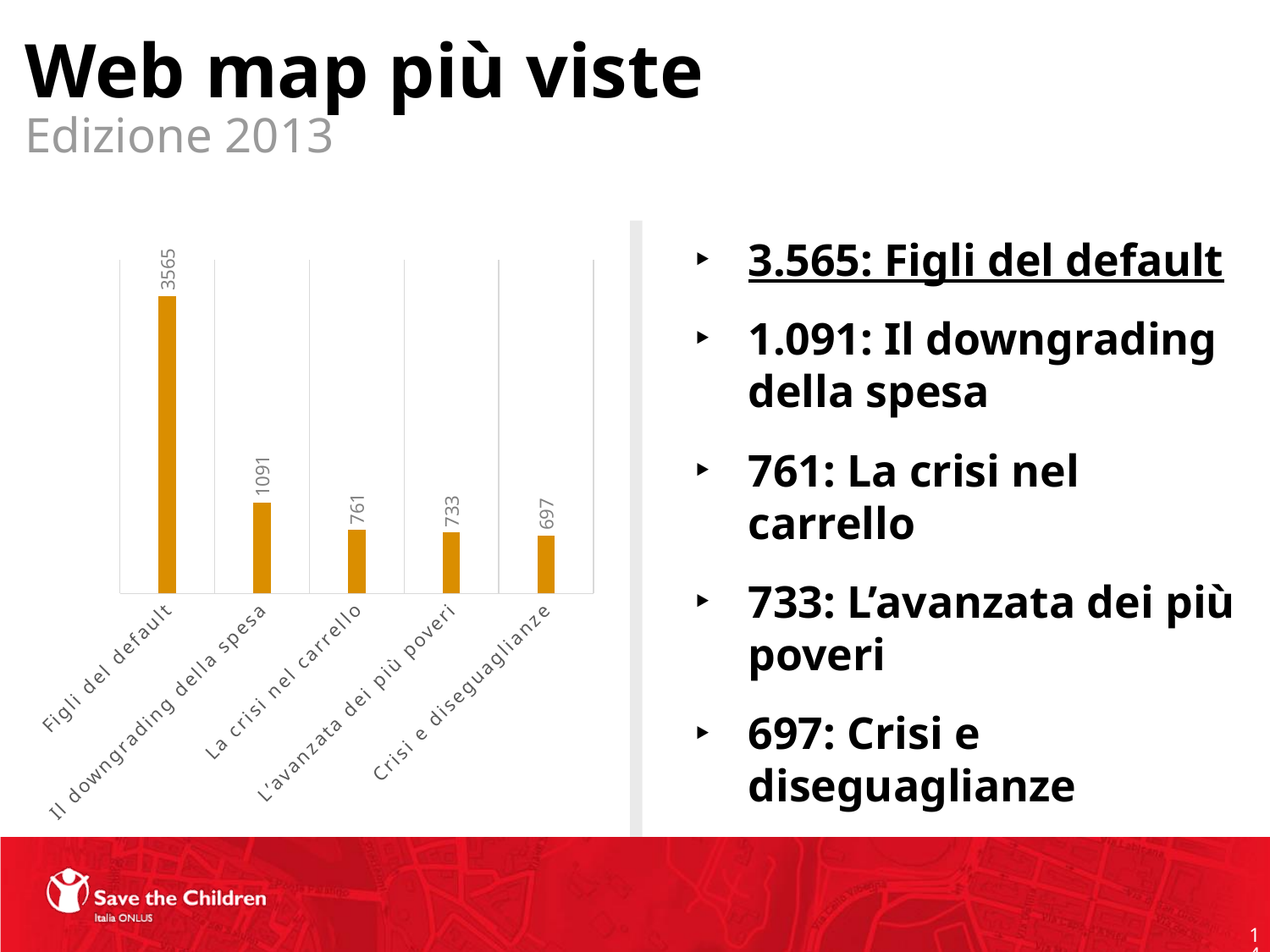
Which category has the highest value? Figli del default What is the value for Il downgrading della spesa? 1091 What is the value for Figli del default? 3565 What is the value for Crisi e diseguaglianze? 697 Which category has the lowest value? Crisi e diseguaglianze How many categories are shown in the chart? 5 Which is larger, the value for Il downgrading della spesa or the value for La crisi nel carrello? Il downgrading della spesa What is the value for L'avanzata dei più poveri? 733 What is the difference between the values for La crisi nel carrello and Crisi e diseguaglianze? 64 What kind of chart is shown on the slide? Bar chart What is the difference between the values for Figli del default and Il downgrading della spesa? 2474 What is the value for La crisi nel carrello? 761